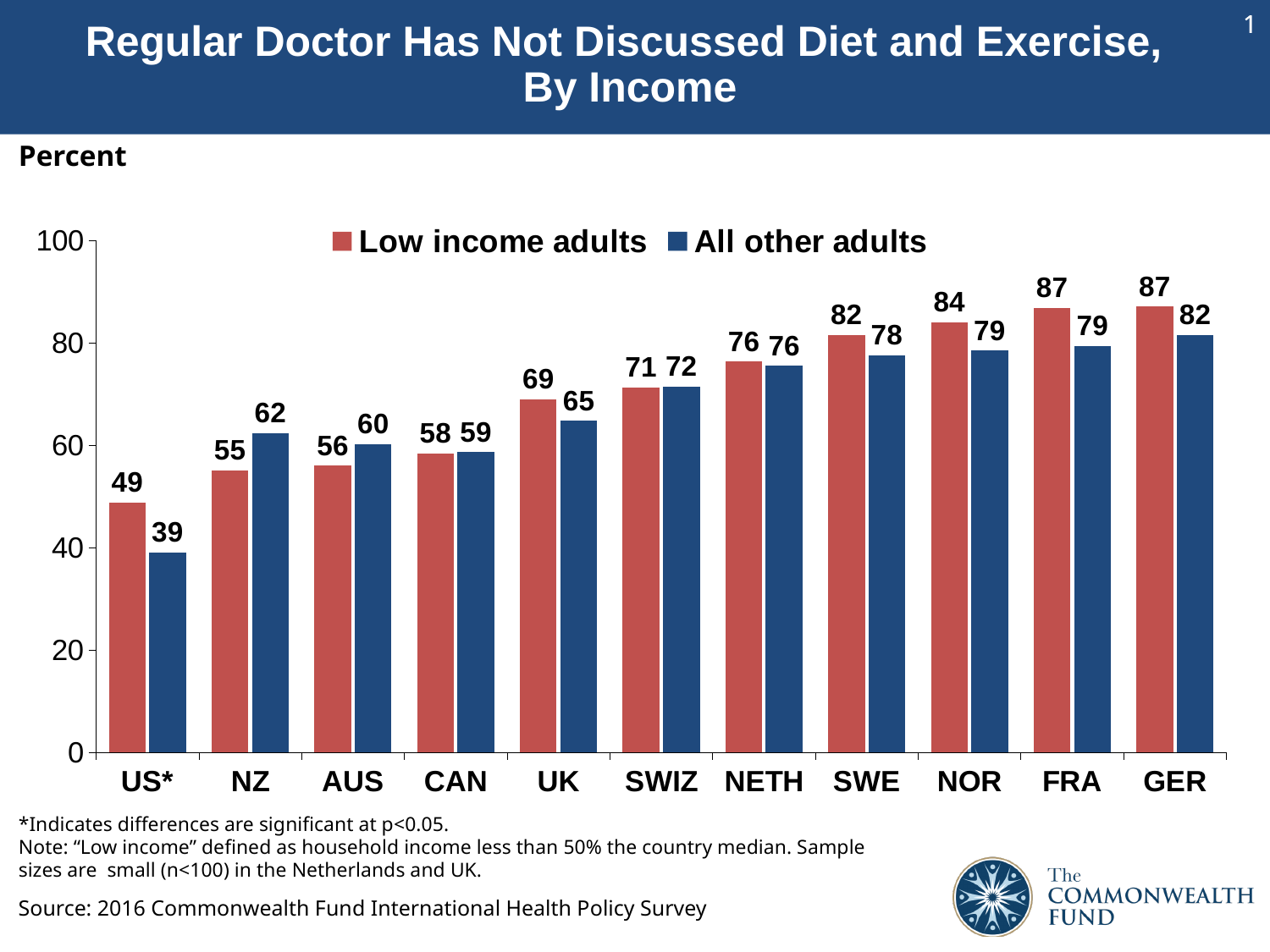
What kind of chart is shown on the slide? Bar chart How many series does the legend list? 2 What is the difference between Low income adults and All other adults in the US*? 10 How many countries are shown on the x axis? 11 Which country has the lowest value for All other adults? US* Which is larger in NZ: the value for Low income adults or All other adults? All other adults What is the value for All other adults in Germany (GER)? 82 Which colour represents Low income adults in the chart? Red What is the difference between Low income adults and All other adults in France (FRA)? 8 What is the value for All other adults in NZ? 62 What is the value for Low income adults in the US*? 49 Which country has the highest value for All other adults? GER